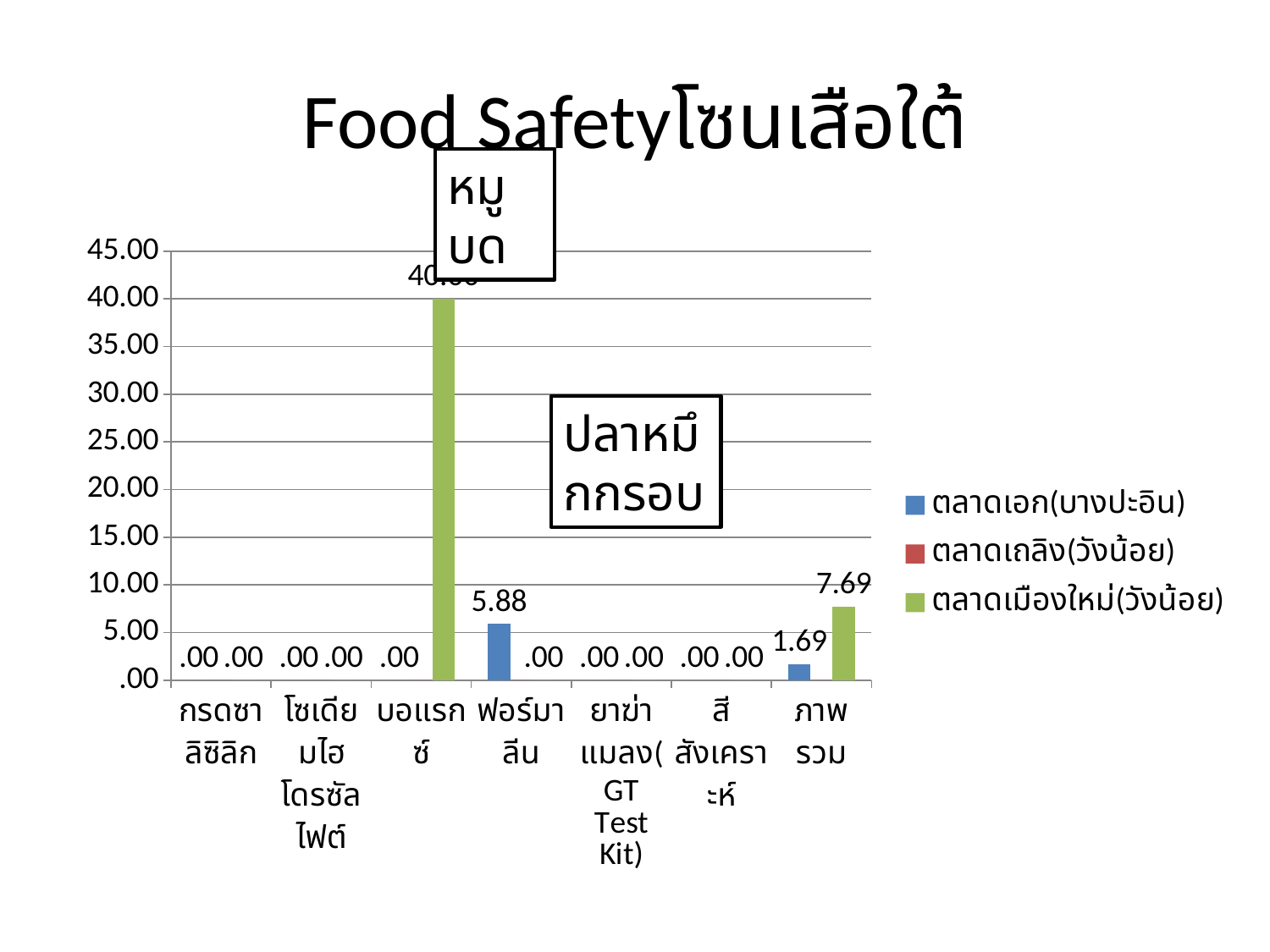
In the ภาพรวม category, which series has the larger value: ตลาดเอก(บางปะอิน) or ตลาดเมืองใหม่(วังน้อย)? ตลาดเมืองใหม่(วังน้อย) What is the value for ตลาดเอก(บางปะอิน) in the ฟอร์มาลีน category? 5.88 What is the difference between the ตลาดเมืองใหม่(วังน้อย) and ตลาดเอก(บางปะอิน) values in the ภาพรวม category? 6.00 How many categories are shown on the x axis? 7 What is the value for ตลาดเมืองใหม่(วังน้อย) in the ภาพรวม category? 7.69 What is the value for ตลาดเมืองใหม่(วังน้อย) in the บอแรกซ์ category? 40.00 How many series does the legend list? 3 Is the value for ตลาดเมืองใหม่(วังน้อย) in the บอแรกซ์ category greater or less than 35.00? greater What is the value for ตลาดเอก(บางปะอิน) in the ภาพรวม category? 1.69 Which category has the highest bar in the chart? บอแรกซ์ What type of chart is shown on the slide? bar chart What is the title of the chart? Food Safetyโซนเสือใต้